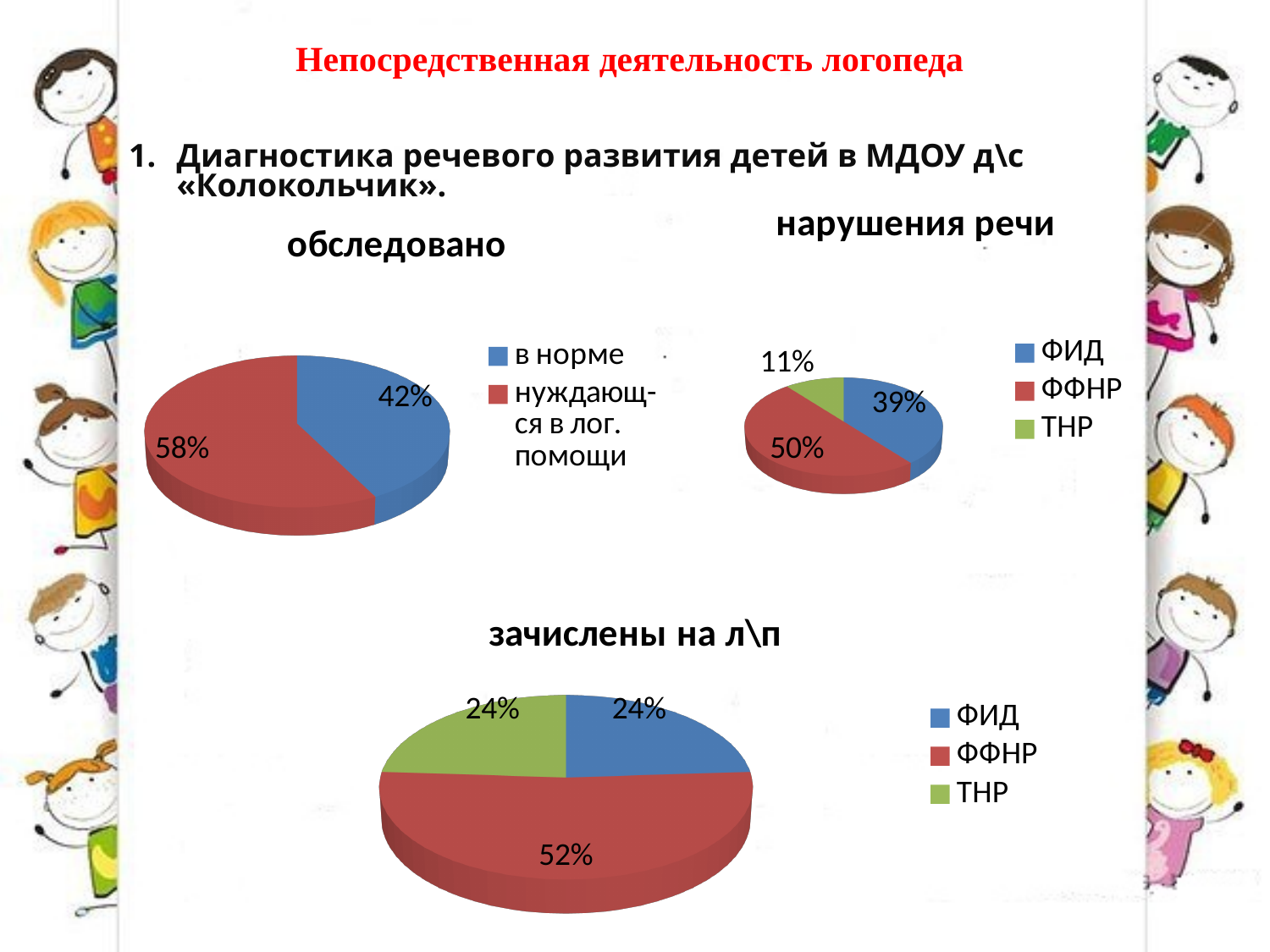
In the "зачислены на л\п" chart, which category has the largest share? ФФНР What kind of chart is the "обследовано" chart? pie chart In the "обследовано" chart, what share is labelled "в норме"? 42% In the "нарушения речи" chart, what share is labelled ТНР? 11% In the "обследовано" chart, which category has the larger share? нуждающ-ся в лог. помощи How many categories does the legend of the "зачислены на л\п" chart list? 3 In the "обследовано" chart, what share is labelled "нуждающ-ся в лог. помощи"? 58% In the "нарушения речи" chart, which category has the smallest share? ТНР In the "зачислены на л\п" chart, what is the difference between the ФФНР and ТНР shares? 28% In the "нарушения речи" chart, what share is labelled ФФНР? 50% In the "нарушения речи" chart, what is the difference between the ФФНР and ФИД shares? 11% In the "зачислены на л\п" chart, what share is labelled ФФНР? 52%